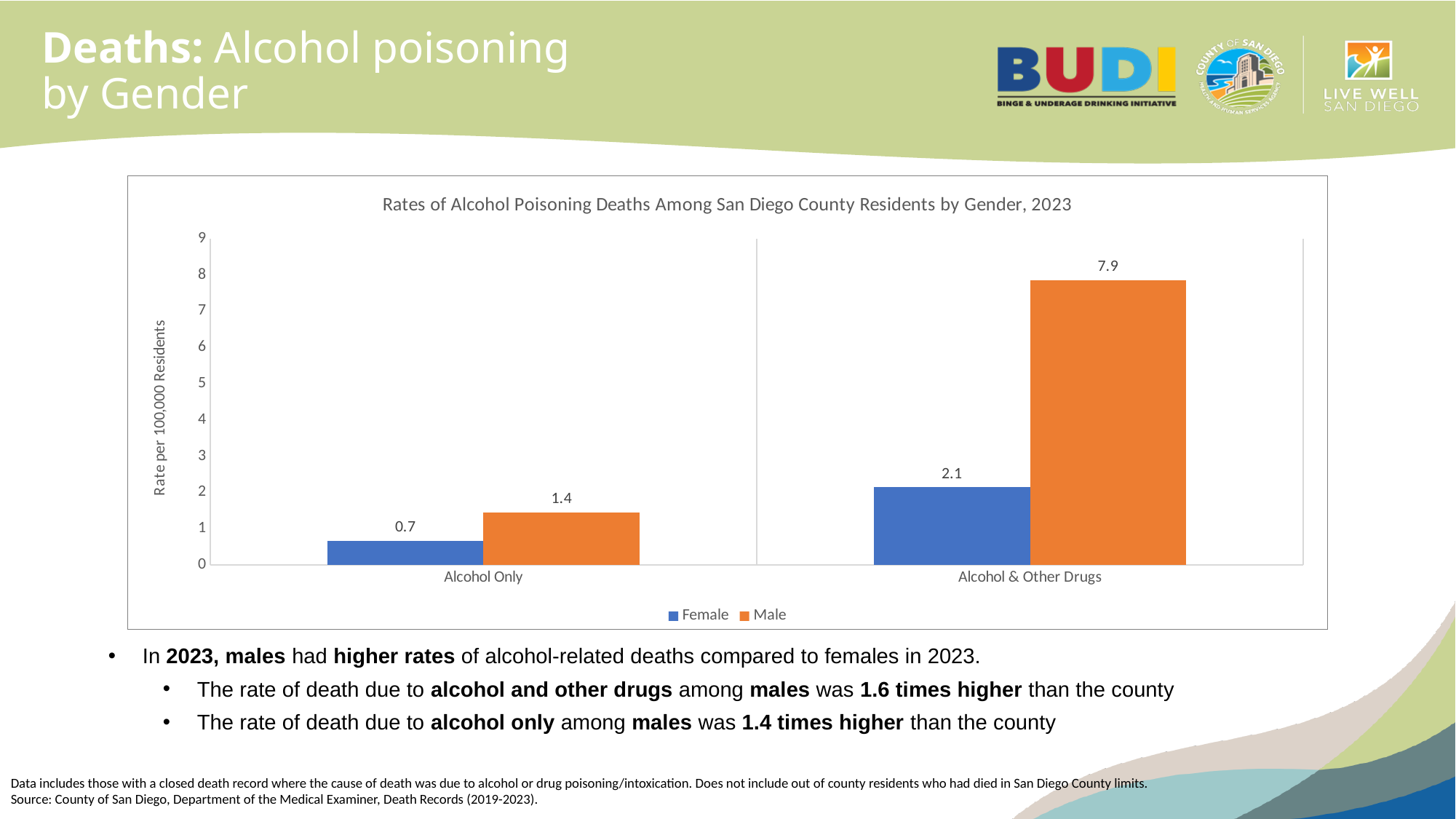
Which category has the highest Male rate? Alcohol & Other Drugs What is the Female rate for Alcohol & Other Drugs? 2.1 Which category has the lowest Female rate? Alcohol Only How many series does the legend list? 2 How many categories are shown on the x axis? 2 What is the Male rate for Alcohol Only? 1.4 Which is larger for Alcohol Only, the Female rate or the Male rate? Male What is the Female rate for Alcohol Only? 0.7 What is the difference between the Male and Female rates for Alcohol & Other Drugs? 5.8 What is the Male rate for Alcohol & Other Drugs? 7.9 Is the Male value for Alcohol & Other Drugs greater or less than 7? greater What kind of chart is shown on the slide? Bar chart